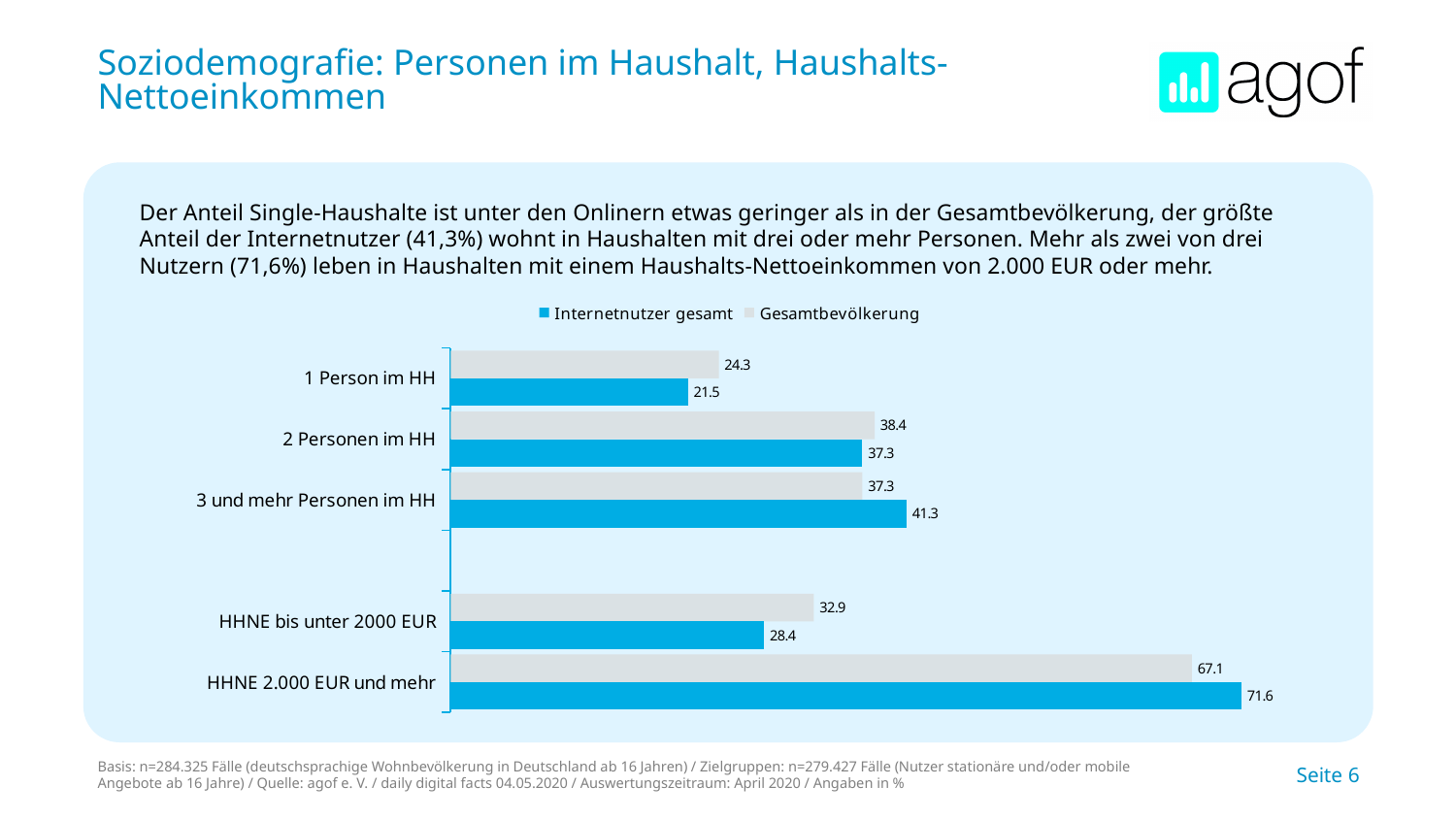
For 'HHNE bis unter 2000 EUR', which series has the larger value, Internetnutzer gesamt or Gesamtbevölkerung? Gesamtbevölkerung What is the value for Gesamtbevölkerung in the category 'HHNE bis unter 2000 EUR'? 32.9 Which category has the lowest value for Gesamtbevölkerung? 1 Person im HH What is the value for Internetnutzer gesamt in the category '1 Person im HH'? 21.5 What kind of chart is shown on the slide? Bar chart What is the value for Gesamtbevölkerung in the category '2 Personen im HH'? 38.4 Which colour represents the series 'Internetnutzer gesamt' in the chart? Blue How many categories are shown on the chart? 5 Which category has the highest value for Internetnutzer gesamt? HHNE 2.000 EUR und mehr What is the value for Internetnutzer gesamt in the category 'HHNE 2.000 EUR und mehr'? 71.6 What is the difference between the Internetnutzer gesamt and Gesamtbevölkerung values for '3 und mehr Personen im HH'? 4.0 How many series does the legend list? 2